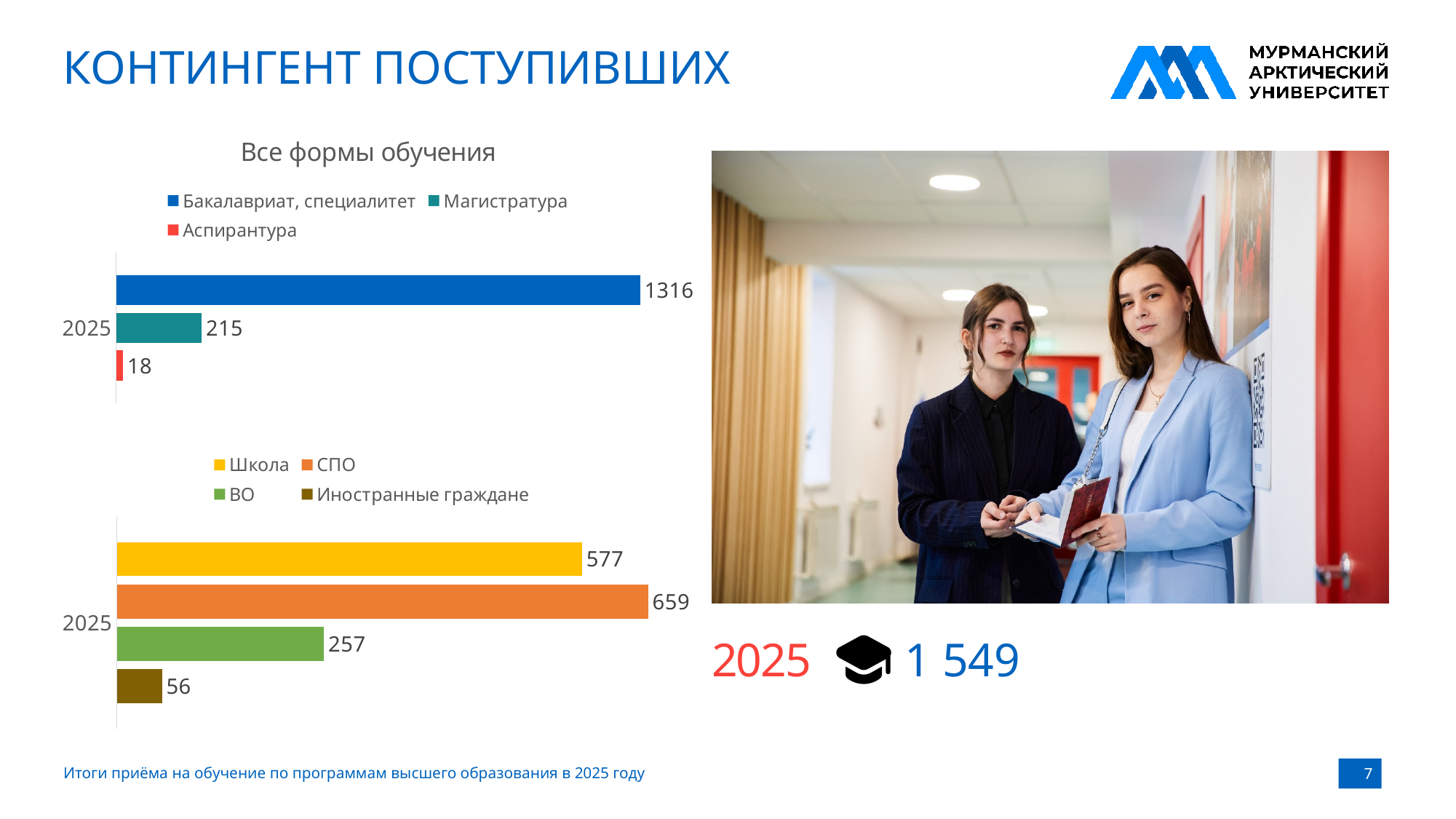
In the top chart titled 'Все формы обучения', which series has the lowest value? Аспирантура In the bottom chart, what is the value for 'СПО'? 659 What type of chart is the bottom chart on the slide? Bar chart In the top chart titled 'Все формы обучения', what is the value for 'Аспирантура'? 18 In the bottom chart, what is the value for 'Иностранные граждане'? 56 In the top chart titled 'Все формы обучения', what is the difference between 'Бакалавриат, специалитет' and 'Магистратура'? 1101 In the top chart titled 'Все формы обучения', what is the value for 'Бакалавриат, специалитет' in 2025? 1316 In the bottom chart, which series has the highest value? СПО In the top chart titled 'Все формы обучения', how many series does the legend list? 3 In the bottom chart, which is larger, 'Школа' or 'ВО'? Школа In the top chart titled 'Все формы обучения', what is the value for 'Магистратура'? 215 In the bottom chart, what is the difference between 'СПО' and 'Школа'? 82